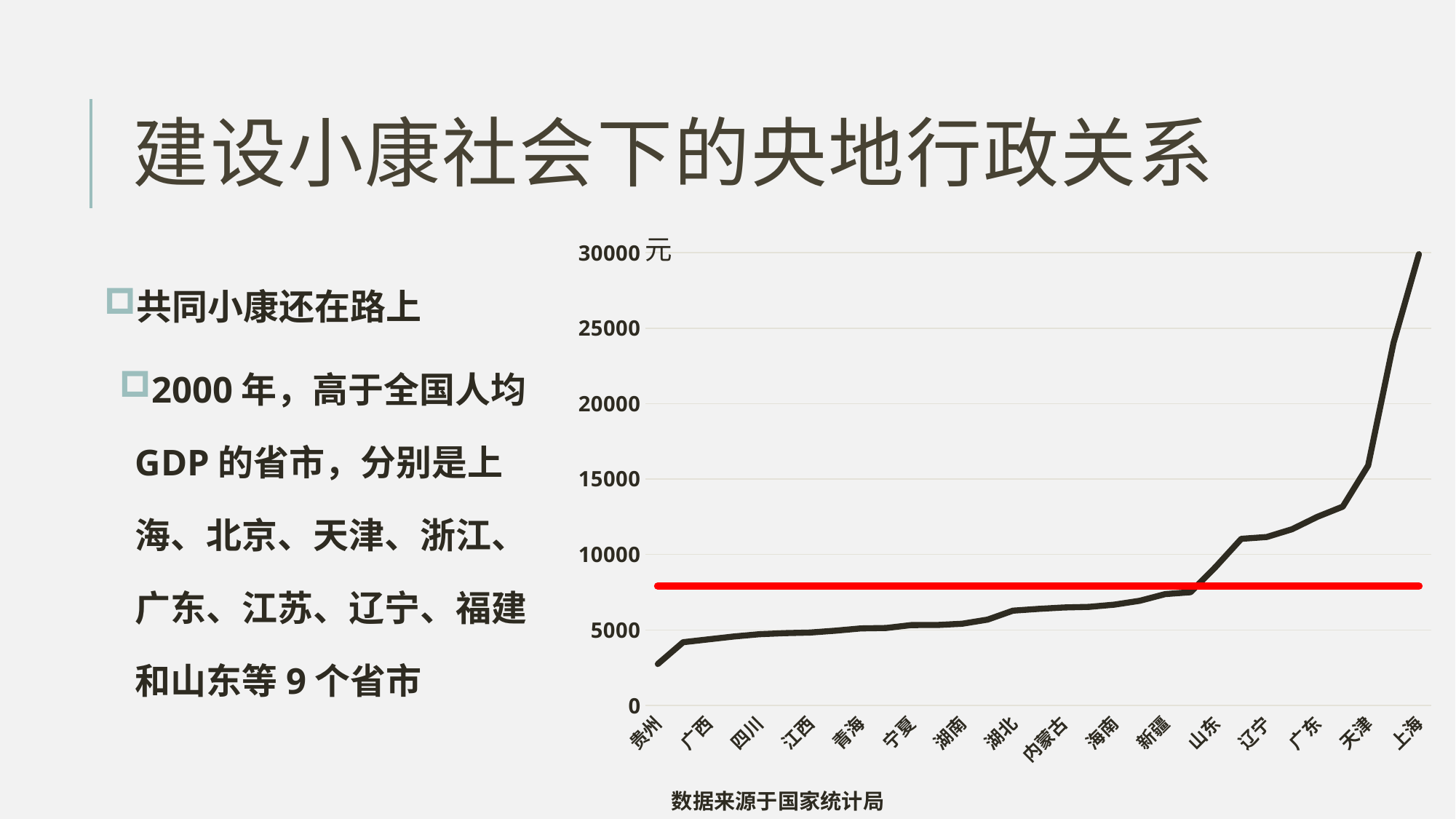
Is the value for 天津 greater or less than 10000? greater Which has a larger value, 上海 or 天津? 上海 Is the value for 上海 greater or less than 25000? greater What unit is shown at the top of the y axis? 元 Is the value for 新疆 greater or less than 5000? greater What kind of chart is shown on the slide? line chart Do the values rise or fall moving from left to right along the x axis? rise Which province or city has the highest value on the chart? 上海 Which province or city has the lowest value on the chart? 贵州 Which has a larger value, 贵州 or 广西? 广西